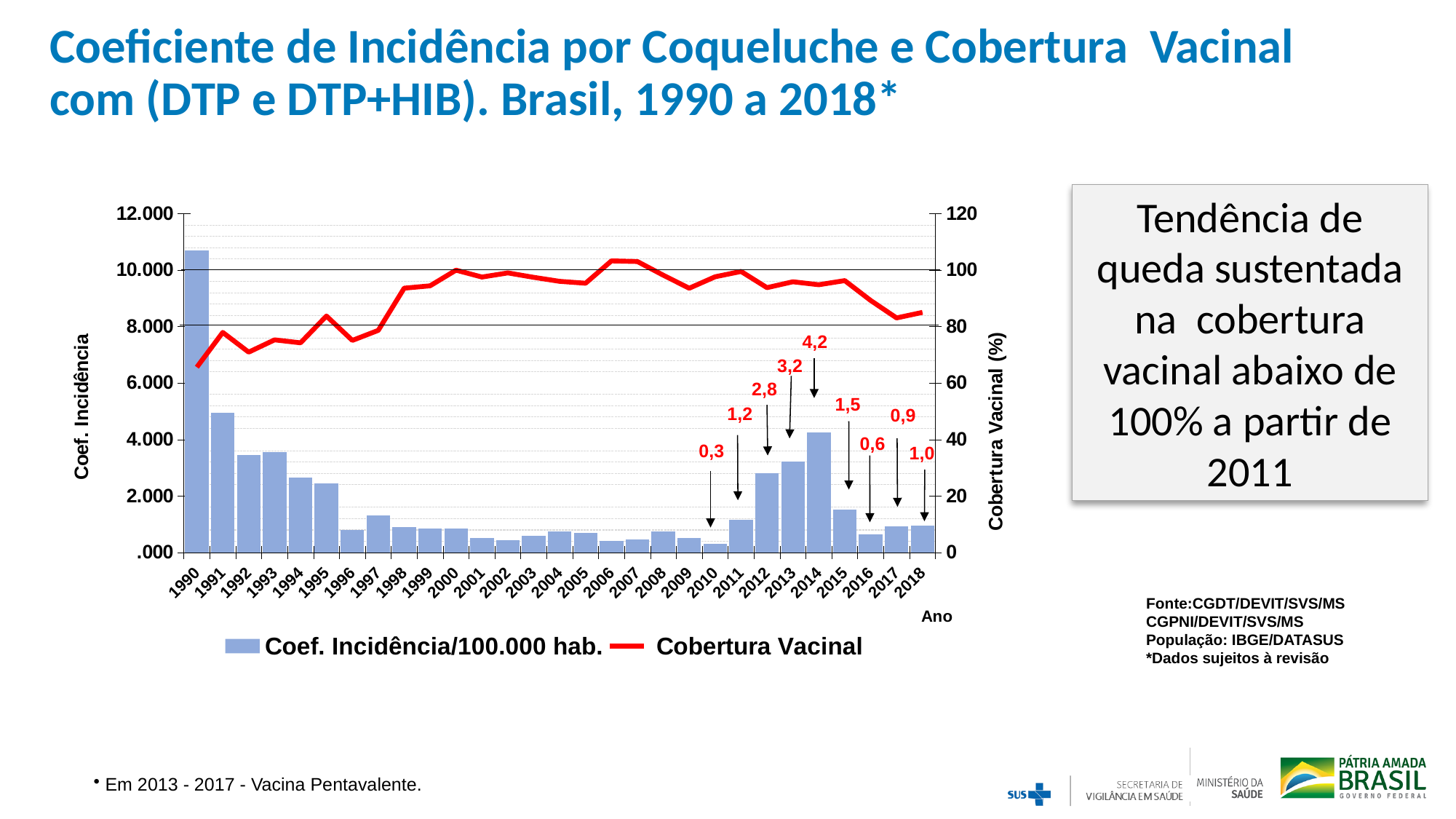
What kind of chart is shown on the slide? A combined bar and line chart Is the Cobertura Vacinal value for 1990 greater or less than 80? less What is the labelled Coef. Incidência value for 2014? 4,2 Which year has the larger labelled Coef. Incidência value, 2013 or 2015? 2013 How many series does the chart legend list? 2 What is the difference between the labelled Coef. Incidência values for 2014 and 2013? 1,0 What is the labelled Coef. Incidência value for 2010? 0,3 What is the labelled Coef. Incidência value for 2012? 2,8 Is the Cobertura Vacinal value for 2017 greater or less than 100? less Which year has the tallest Coef. Incidência bar in the chart? 1990 How many years are shown along the x axis of the chart? 29 Do the Coef. Incidência bars rise or fall from 1990 to 1996? fall